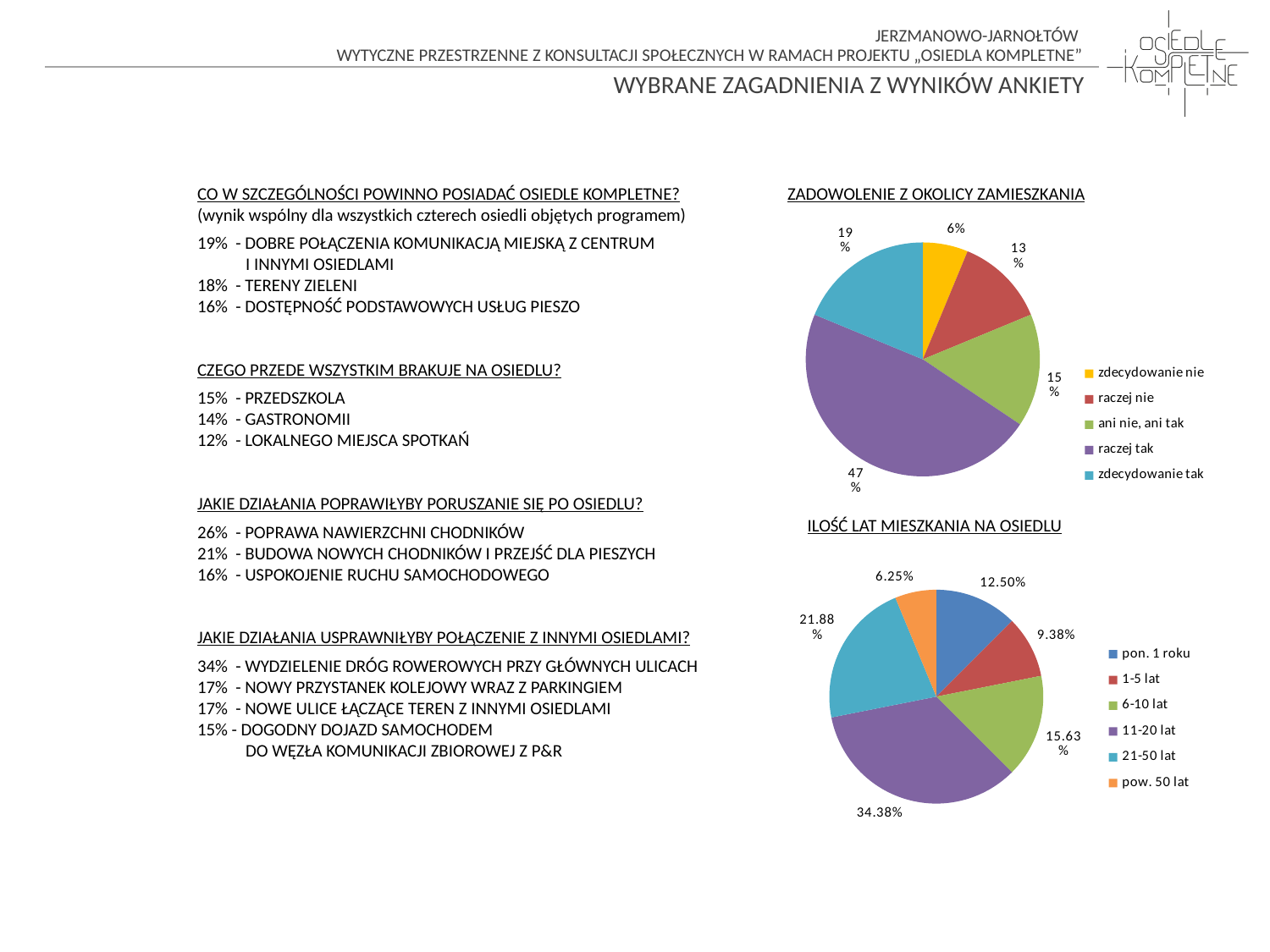
In the chart titled "ZADOWOLENIE Z OKOLICY ZAMIESZKANIA", what share is labelled for "raczej tak"? 47% In the chart titled "ZADOWOLENIE Z OKOLICY ZAMIESZKANIA", how many categories does the legend list? 5 In the chart titled "ZADOWOLENIE Z OKOLICY ZAMIESZKANIA", which category has the smallest slice? zdecydowanie nie What kind of chart is the one titled "ILOŚĆ LAT MIESZKANIA NA OSIEDLU"? pie chart In the chart titled "ILOŚĆ LAT MIESZKANIA NA OSIEDLU", what share is labelled for "11-20 lat"? 34.38% In the chart titled "ZADOWOLENIE Z OKOLICY ZAMIESZKANIA", what is the difference between the shares for "zdecydowanie tak" and "raczej nie"? 6% In the chart titled "ILOŚĆ LAT MIESZKANIA NA OSIEDLU", which is larger: the share for "21-50 lat" or the share for "6-10 lat"? 21-50 lat In the chart titled "ILOŚĆ LAT MIESZKANIA NA OSIEDLU", which category has the smallest slice? pow. 50 lat In the chart titled "ILOŚĆ LAT MIESZKANIA NA OSIEDLU", what share is labelled for "pow. 50 lat"? 6.25% In the chart titled "ZADOWOLENIE Z OKOLICY ZAMIESZKANIA", what share is labelled for "zdecydowanie nie"? 6% In the chart titled "ZADOWOLENIE Z OKOLICY ZAMIESZKANIA", which category has the largest slice? raczej tak In the chart titled "ILOŚĆ LAT MIESZKANIA NA OSIEDLU", how many categories does the legend list? 6